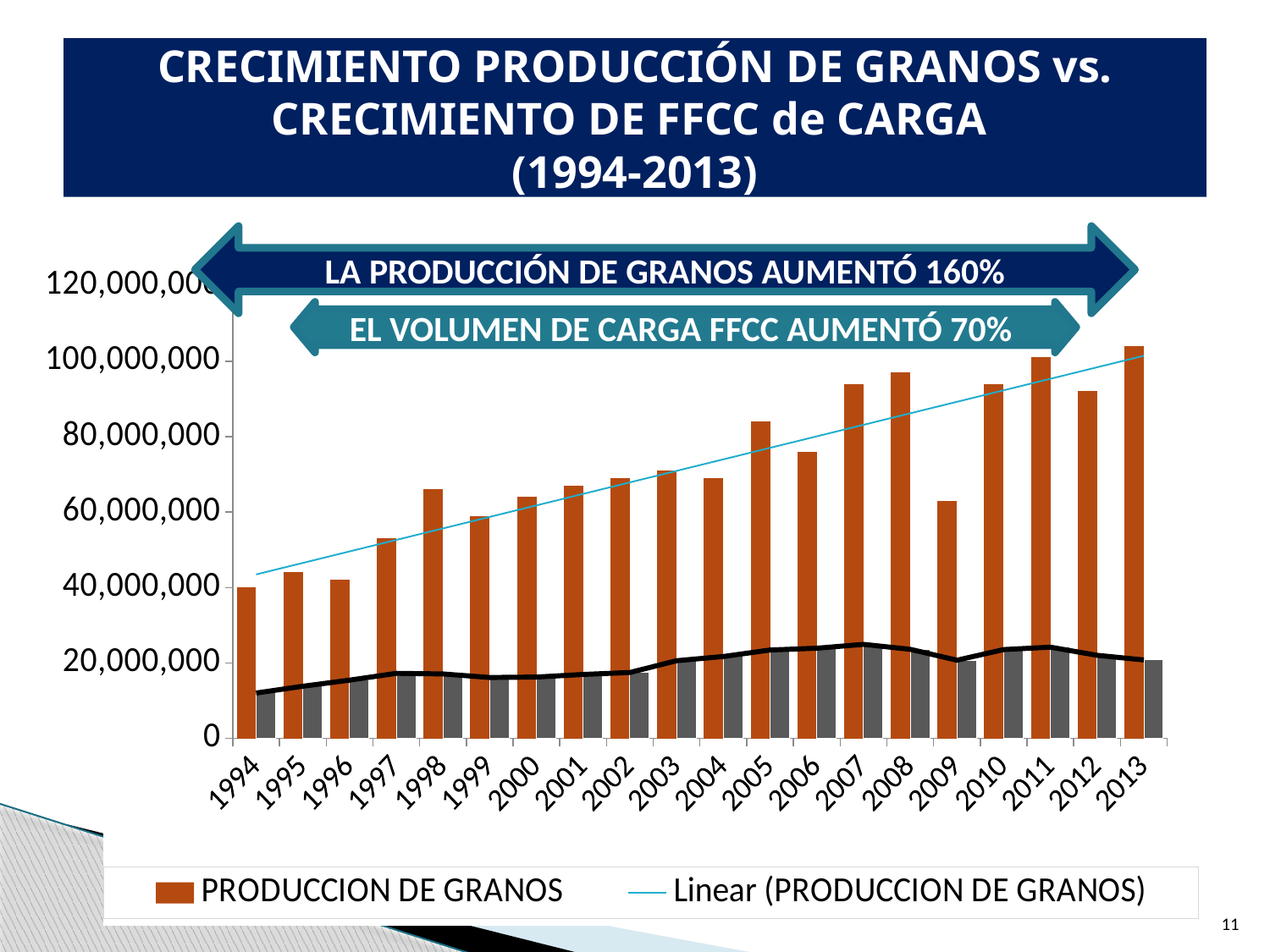
Is the PRODUCCION DE GRANOS value for 2007 greater or less than 80,000,000? greater Is the PRODUCCION DE GRANOS value for 2012 greater or less than 100,000,000? less Which year has the highest PRODUCCION DE GRANOS bar? 2013 What is the first entry listed in the chart legend? PRODUCCION DE GRANOS Which year has a larger PRODUCCION DE GRANOS bar, 2012 or 2013? 2013 Overall, do the PRODUCCION DE GRANOS bars rise or fall from 1994 to 2013? rise What kind of chart is shown on the slide? combination bar and line chart Is the PRODUCCION DE GRANOS value for 1996 greater or less than 60,000,000? less Which year has the lowest PRODUCCION DE GRANOS bar? 1994 How many years are shown along the x axis of the chart? 20 Which year has a larger PRODUCCION DE GRANOS bar, 2008 or 2009? 2008 How many entries does the chart legend list? 2